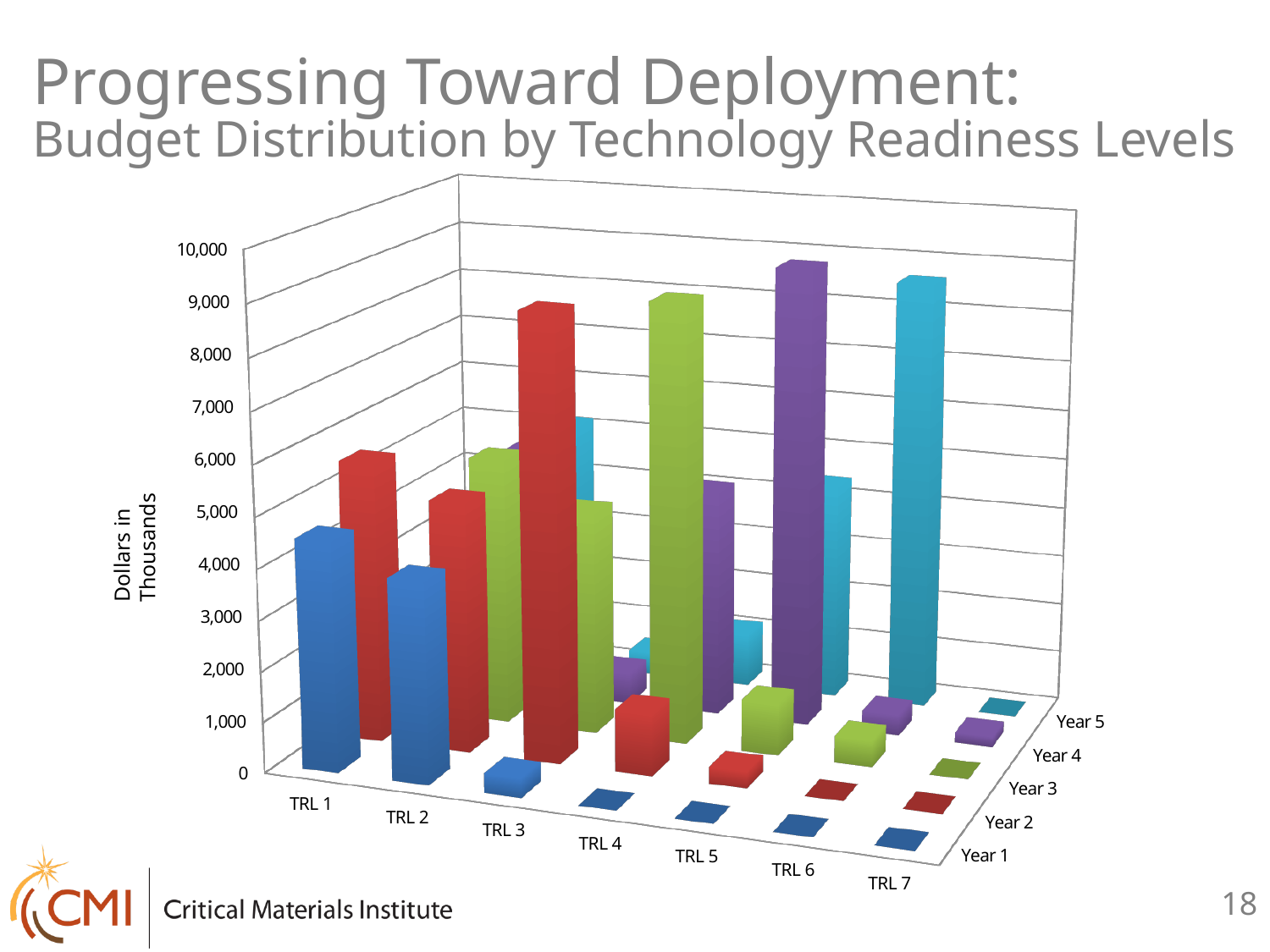
Which TRL has the highest value in Year 1? TRL 1 Is the Year 5 value for TRL 6 greater or less than 6,000? greater What kind of chart is shown on the slide? bar chart Is the Year 2 value for TRL 3 greater or less than 7,000? greater Is the Year 1 value for TRL 1 greater or less than 2,000? greater Do the Year 1 values rise or fall from TRL 1 to TRL 7? fall How many TRL categories are shown along the x axis? 7 What is the highest value shown on the vertical axis? 10,000 What is the title of the vertical axis? Dollars in Thousands How many years (series) are plotted in the chart? 5